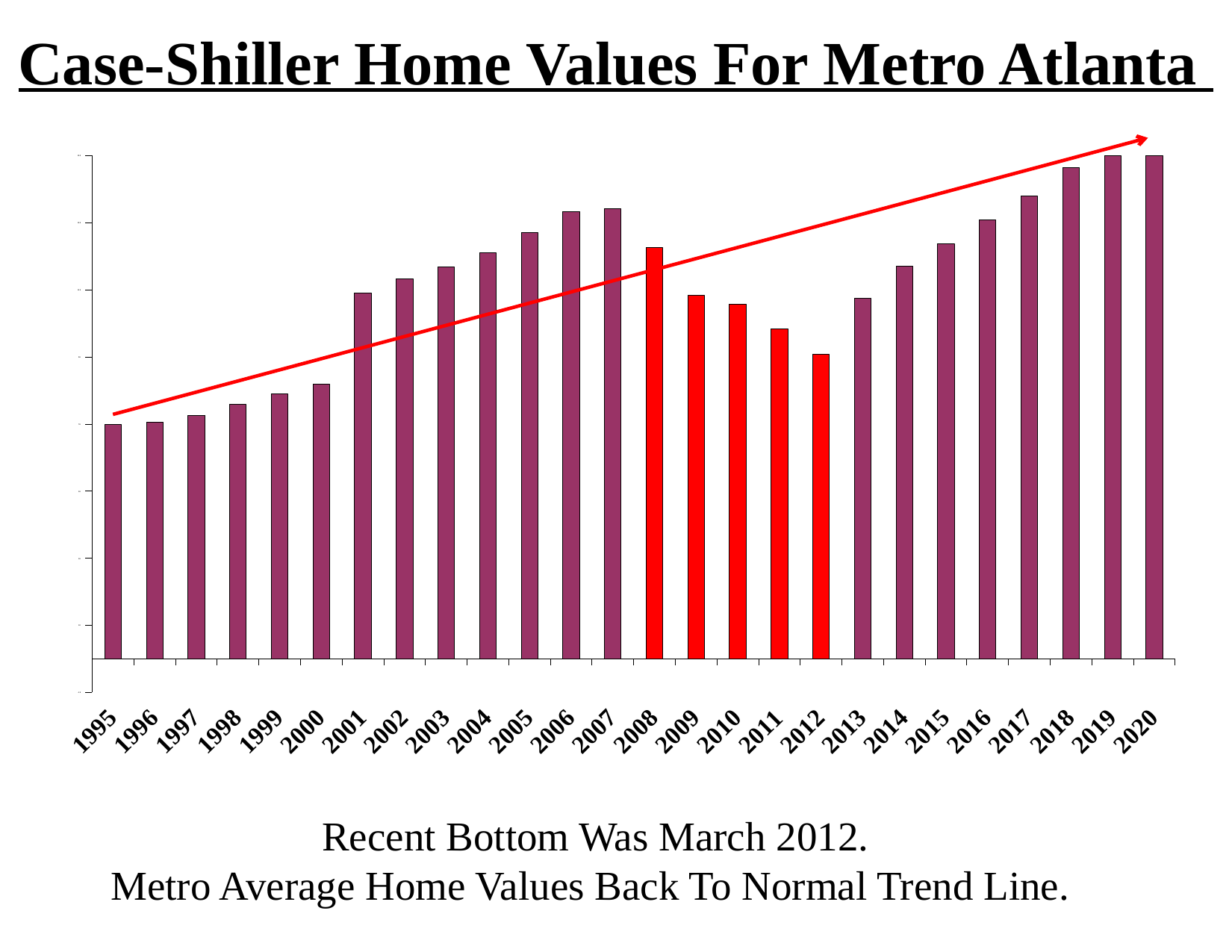
Which years are shown with bright red bars in the chart? 2008, 2009, 2010, 2011, 2012 Do the values rise or fall from 2012 to 2020? rise Which year has the higher value, 1995 or 2005? 2005 What is the title of the slide's chart? Case-Shiller Home Values For Metro Atlanta Which year has the higher value, 2000 or 2001? 2001 Which year has the higher value, 2013 or 2018? 2018 What kind of chart is shown on the slide? bar chart Do the values rise or fall from 2008 to 2012? fall How many years are shown along the x axis of the chart? 26 Do the values rise or fall from 1995 to 2007? rise Among the red bars (2008 to 2012), which year has the lowest value? 2012